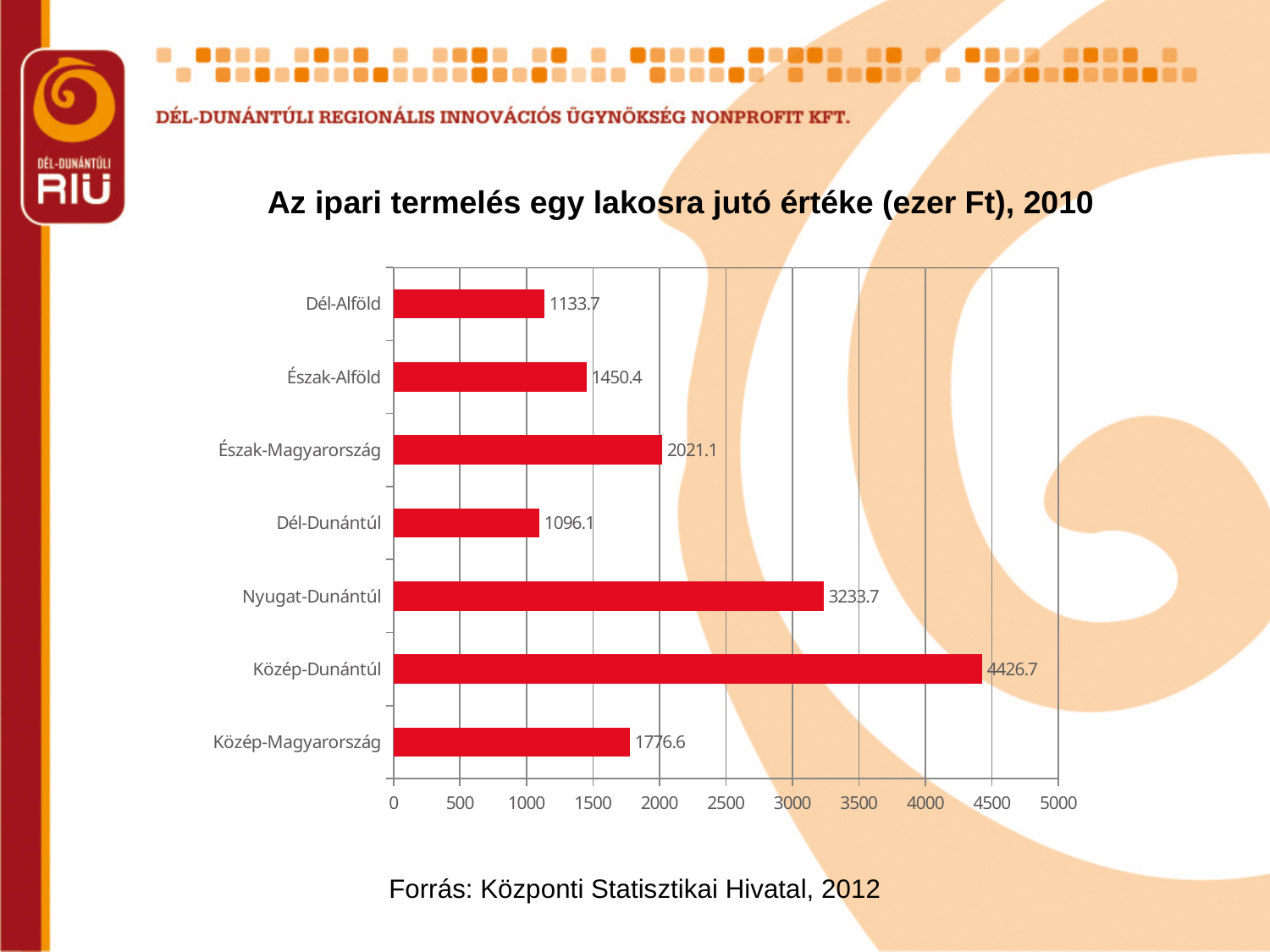
What is the value for Észak-Magyarország? 2021.1 Which region has the lowest value? Dél-Dunántúl What kind of chart is shown on the slide? bar chart How many regions are shown in the chart? 7 Which has a larger value, Nyugat-Dunántúl or Észak-Magyarország? Nyugat-Dunántúl Which region has the highest value? Közép-Dunántúl Is the value for Közép-Magyarország greater or less than 2000? less What is the value for Dél-Dunántúl? 1096.1 What is the value for Közép-Magyarország? 1776.6 What is the value for Közép-Dunántúl? 4426.7 What is the difference between the values for Közép-Dunántúl and Nyugat-Dunántúl? 1193.0 What is the difference between the values for Észak-Alföld and Dél-Alföld? 316.7